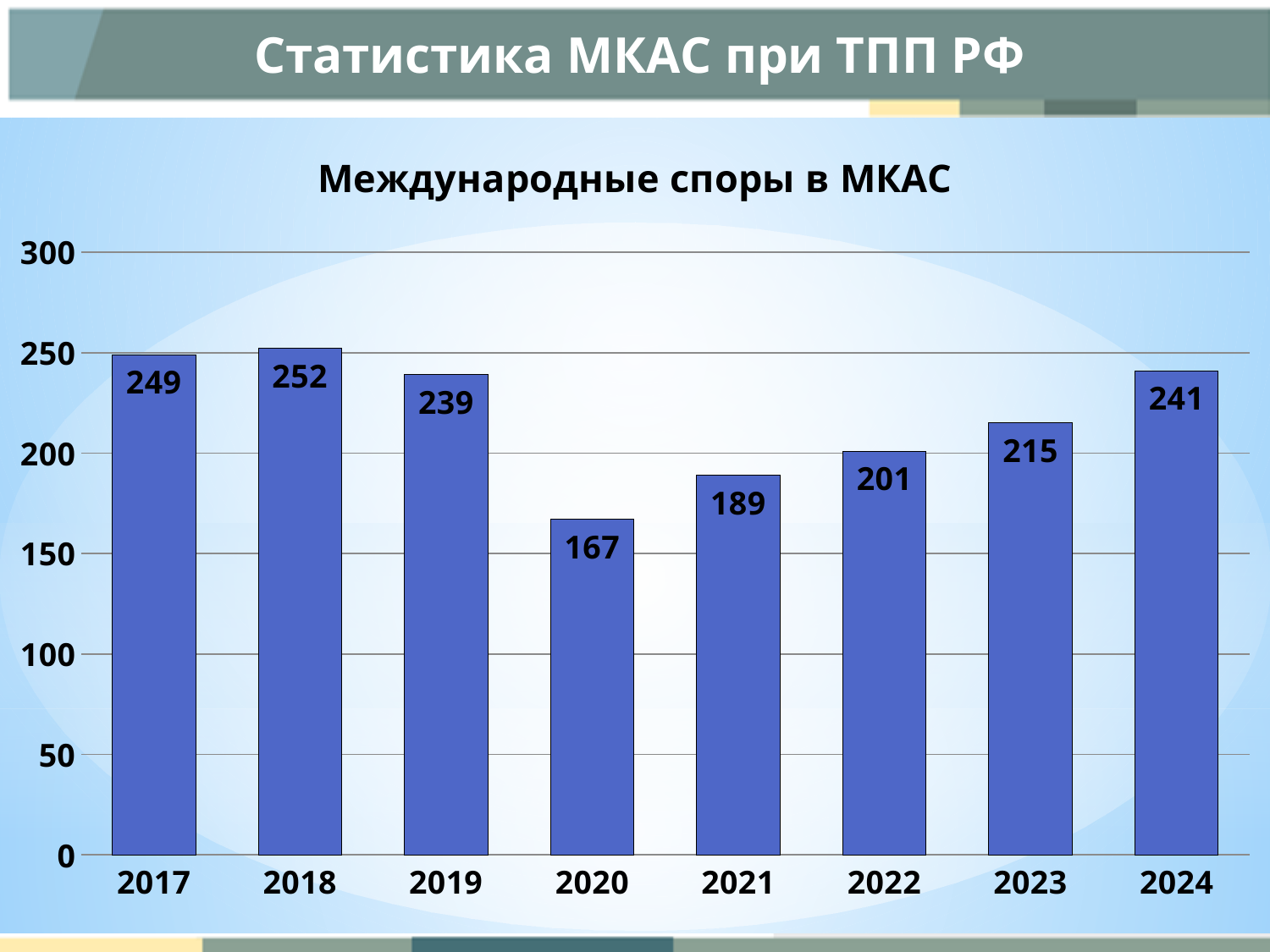
Which year has the lowest value? 2020 What is the difference between the values for 2017 and 2019? 10 What is the difference between the values for 2018 and 2020? 85 Which is larger, the value for 2021 or the value for 2023? 2023 What is the value for 2024? 241 Is the value for 2022 greater or less than 250? less How many years are shown on the x axis? 8 Do the values rise or fall from 2020 to 2024? rise What is the title of the chart? Международные споры в МКАС What kind of chart is this? bar chart Which year has the highest value? 2018 What is the value for 2020? 167